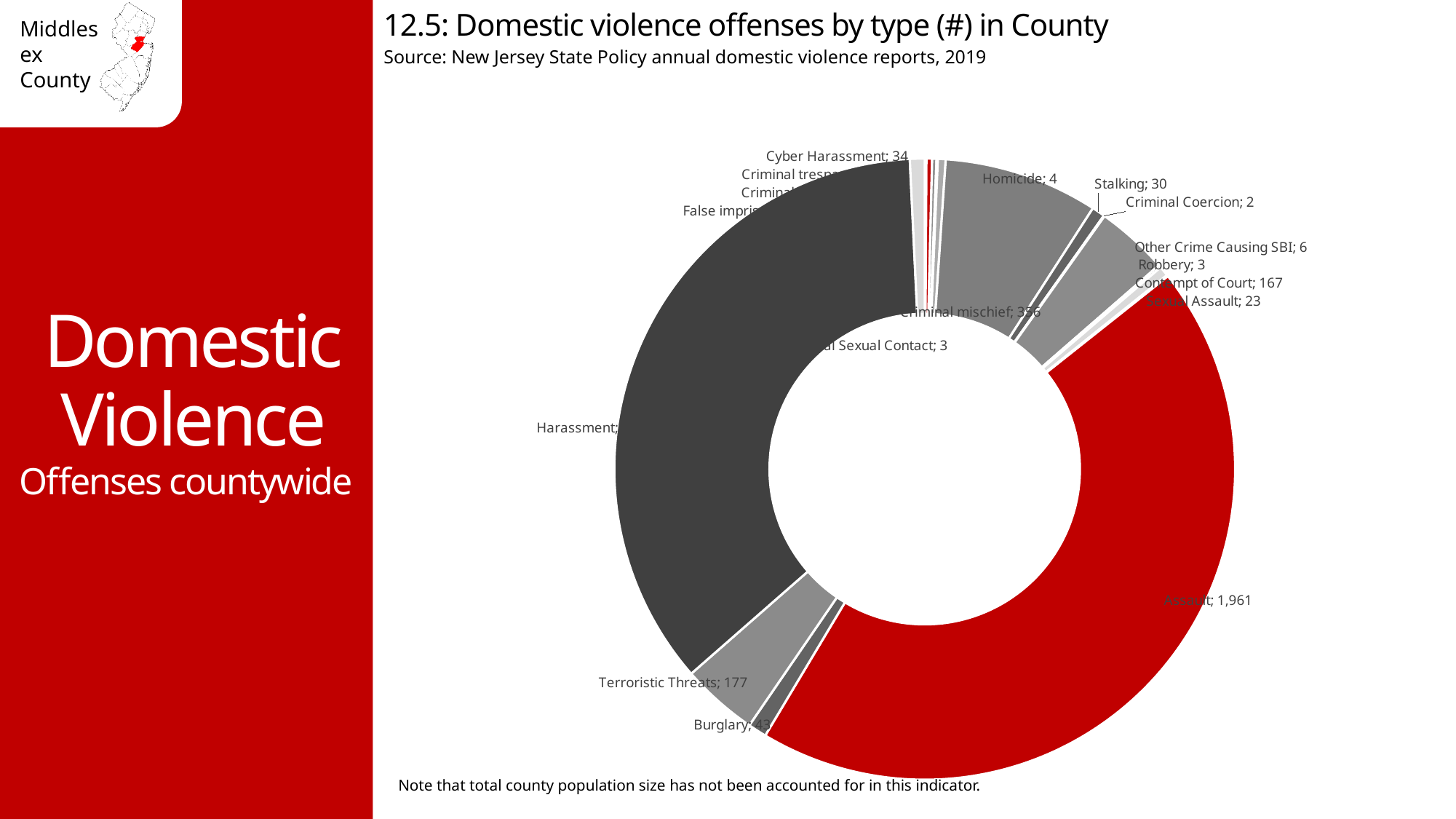
What is the value for Terroristic Threats? 177 What kind of chart is shown on the slide? Pie (doughnut) chart What is the title of the chart? 12.5: Domestic violence offenses by type (#) in County What is the value for Cyber Harassment? 34 What is the difference between the Terroristic Threats value and the Contempt of Court value? 10 What is the value for Sexual Assault? 23 How many Assault offenses are shown in the chart? 1,961 What is the value for Homicide? 4 What is the value for Stalking? 30 Which offense type has the largest slice in the chart? Assault Which is larger, Terroristic Threats or Contempt of Court? Terroristic Threats What is the value for Contempt of Court? 167